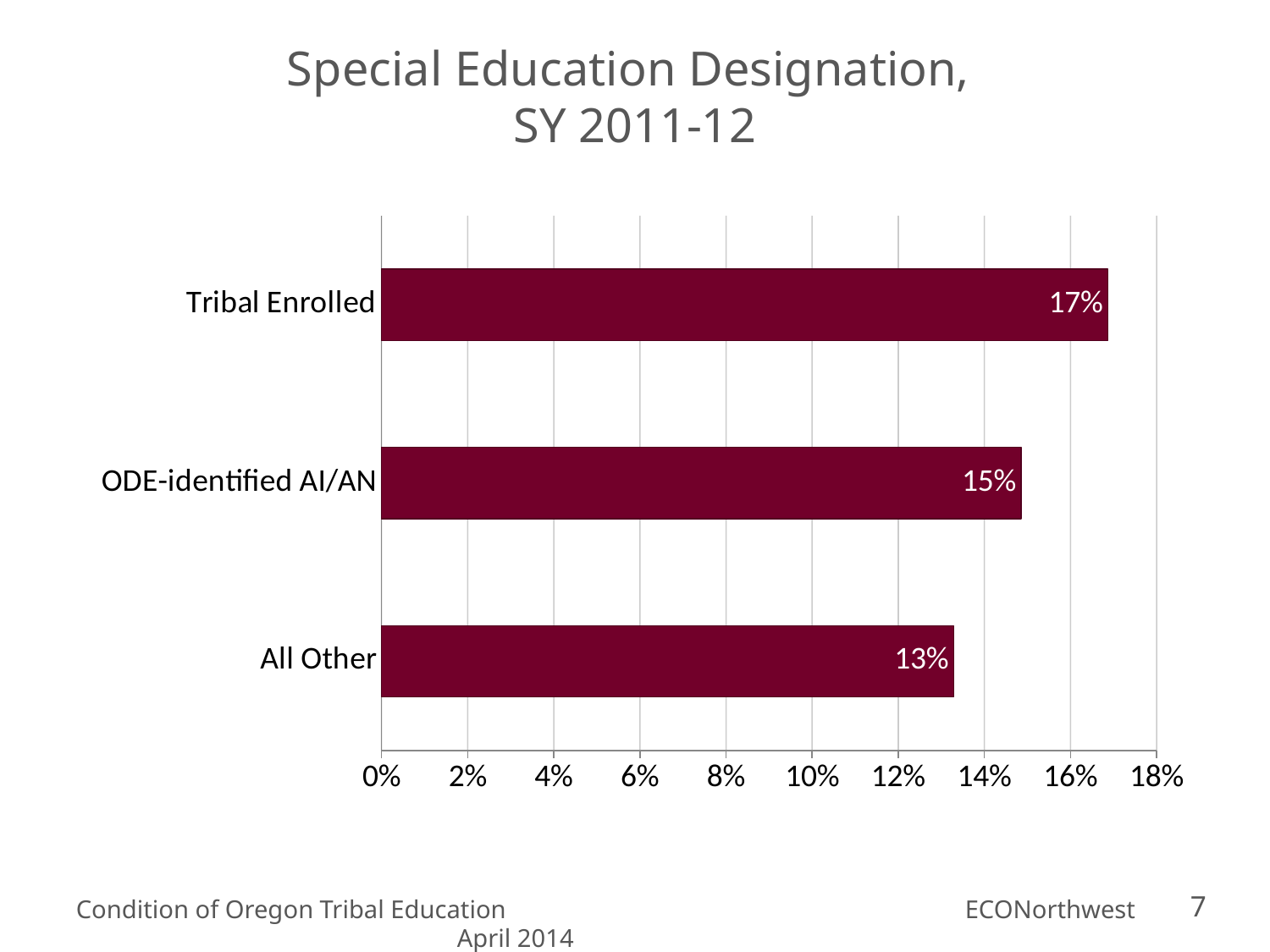
How many categories are shown in the chart? 3 Which category has the highest value? Tribal Enrolled What is the value for ODE-identified AI/AN? 15% What is the difference between the values for Tribal Enrolled and All Other? 4% Which category has the lowest value? All Other What is the difference between the values for ODE-identified AI/AN and All Other? 2% What is the value for Tribal Enrolled? 17% What kind of chart is shown on the slide? bar chart Is the value for All Other greater or less than 14%? less What is the title of the chart? Special Education Designation, SY 2011-12 What is the value for All Other? 13% Which is larger, the value for Tribal Enrolled or the value for ODE-identified AI/AN? Tribal Enrolled